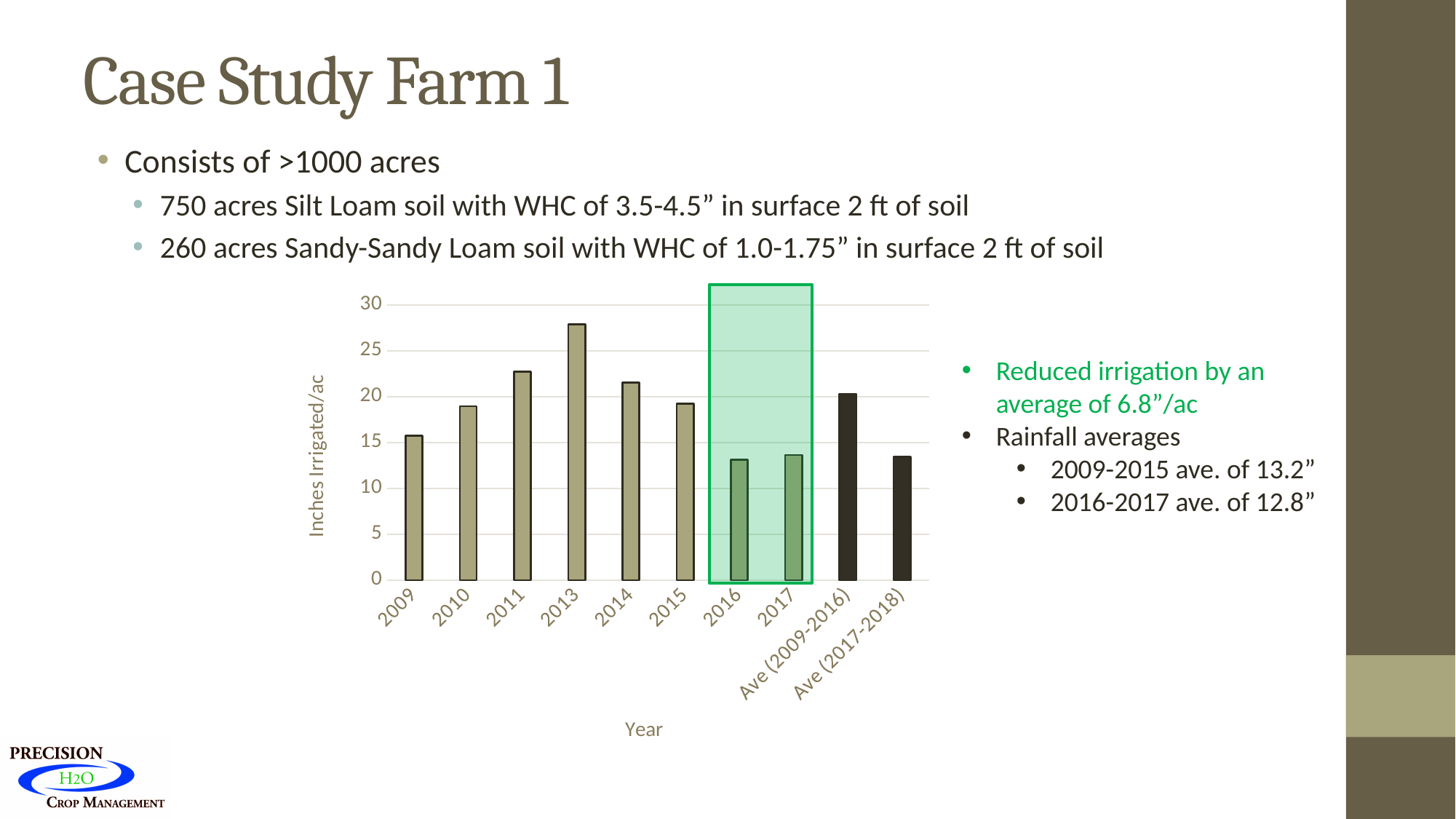
Which is larger, the value for Ave (2009-2016) or the value for Ave (2017-2018)? Ave (2009-2016) Do the values rise or fall from 2013 to 2016? fall What is the title of the vertical axis of the chart? Inches Irrigated/ac What kind of chart is shown on the slide? bar chart Is the value for 2016 greater or less than 15? less Is the value for 2009 greater or less than 20? less Is the value for Ave (2017-2018) greater or less than 15? less Which year has the highest inches irrigated per acre? 2013 Which is larger, the value for 2013 or the value for 2016? 2013 How many categories are shown on the x axis of the chart? 10